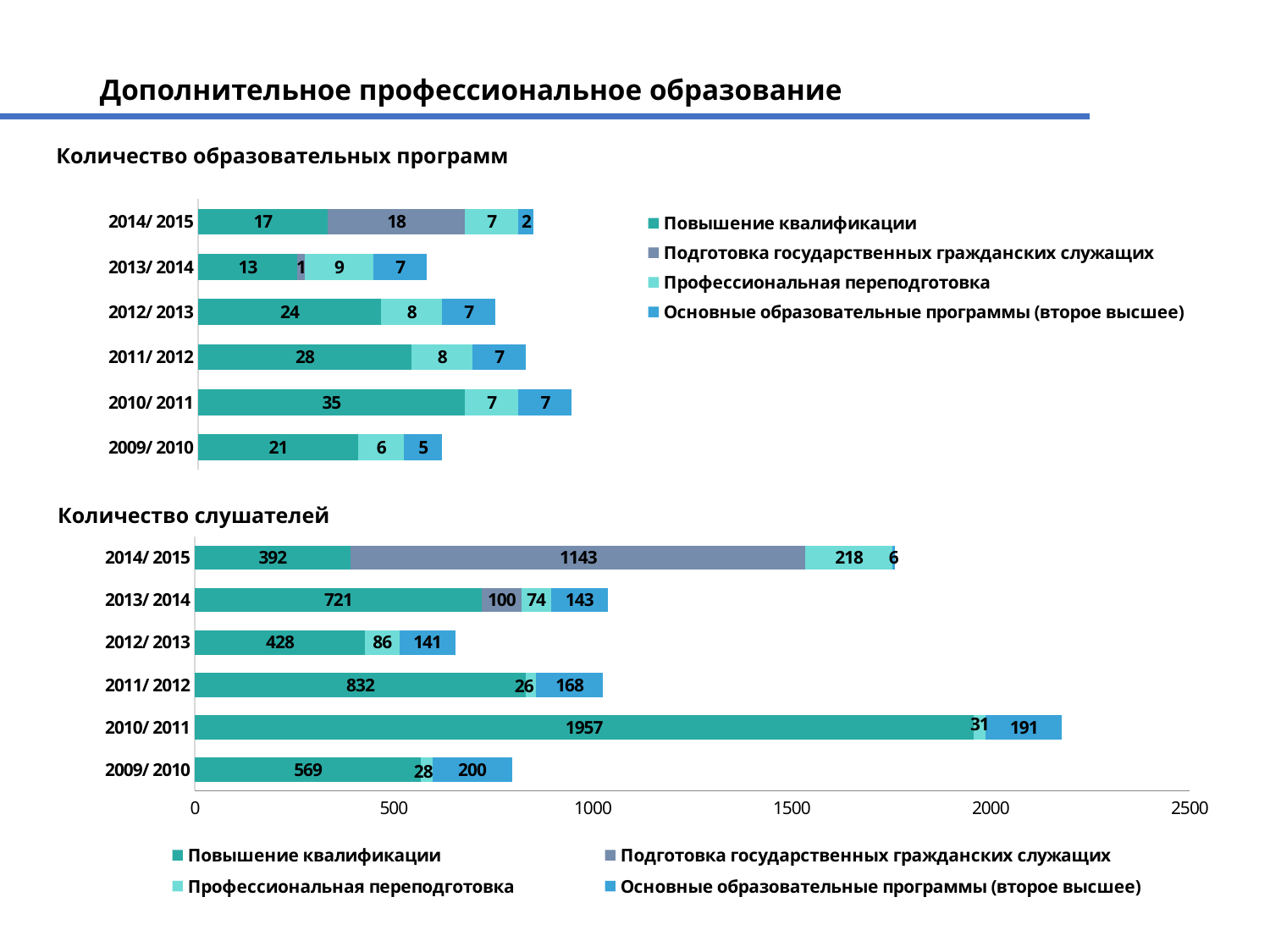
How many series does the legend of the chart 'Количество образовательных программ' list? 4 What type of chart is 'Количество слушателей'? Stacked bar chart In the chart 'Количество слушателей', what is the value for Основные образовательные программы (второе высшее) in 2009/2010? 200 In the chart 'Количество слушателей', what is the difference between Повышение квалификации in 2011/2012 and in 2012/2013? 404 In the chart 'Количество образовательных программ', what is the total of the stacked bar for 2014/2015? 44 In the chart 'Количество образовательных программ', what is the value for Подготовка государственных гражданских служащих in 2014/2015? 18 How many years (categories) are shown in the chart 'Количество слушателей'? 6 In the chart 'Количество образовательных программ', which is larger: Повышение квалификации in 2012/2013 or in 2013/2014? 2012/2013 In the chart 'Количество слушателей', what is the value for Повышение квалификации in 2010/2011? 1957 In the chart 'Количество слушателей', what is the total of the stacked bar for 2013/2014? 1038 In the chart 'Количество слушателей', which year has the lowest value for Повышение квалификации? 2014/2015 In the chart 'Количество образовательных программ', which year has the highest value for Повышение квалификации? 2010/2011